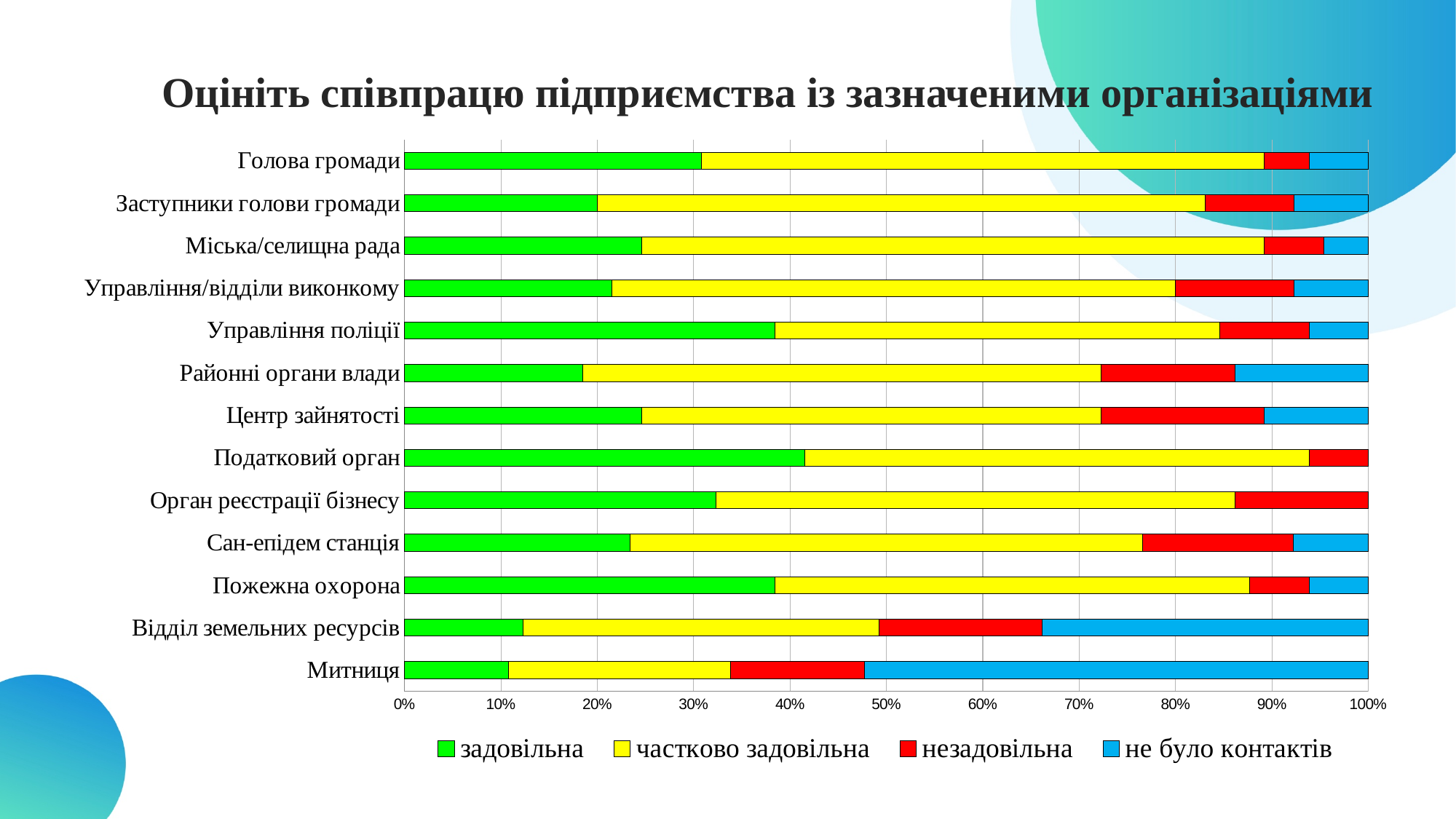
Which organisation has the largest "задовільна" share? Податковий орган Which colour represents the series "не було контактів" in the legend? blue How many series does the legend list? 4 Is the "задовільна" value for Митниця greater or less than 20%? less Which has the larger "задовільна" share: Голова громади or Заступники голови громади? Голова громади Is the "задовільна" value for Податковий орган greater or less than 30%? greater What is the total of the stacked bar for Митниця? 100% How many organisations (categories) are listed on the chart? 13 Which organisation has the largest "не було контактів" share? Митниця What kind of chart is shown on the slide? stacked bar chart Is the "не було контактів" value for Митниця greater or less than 40%? greater What is the title of the chart? Оцініть співпрацю підприємства із зазначеними організаціями